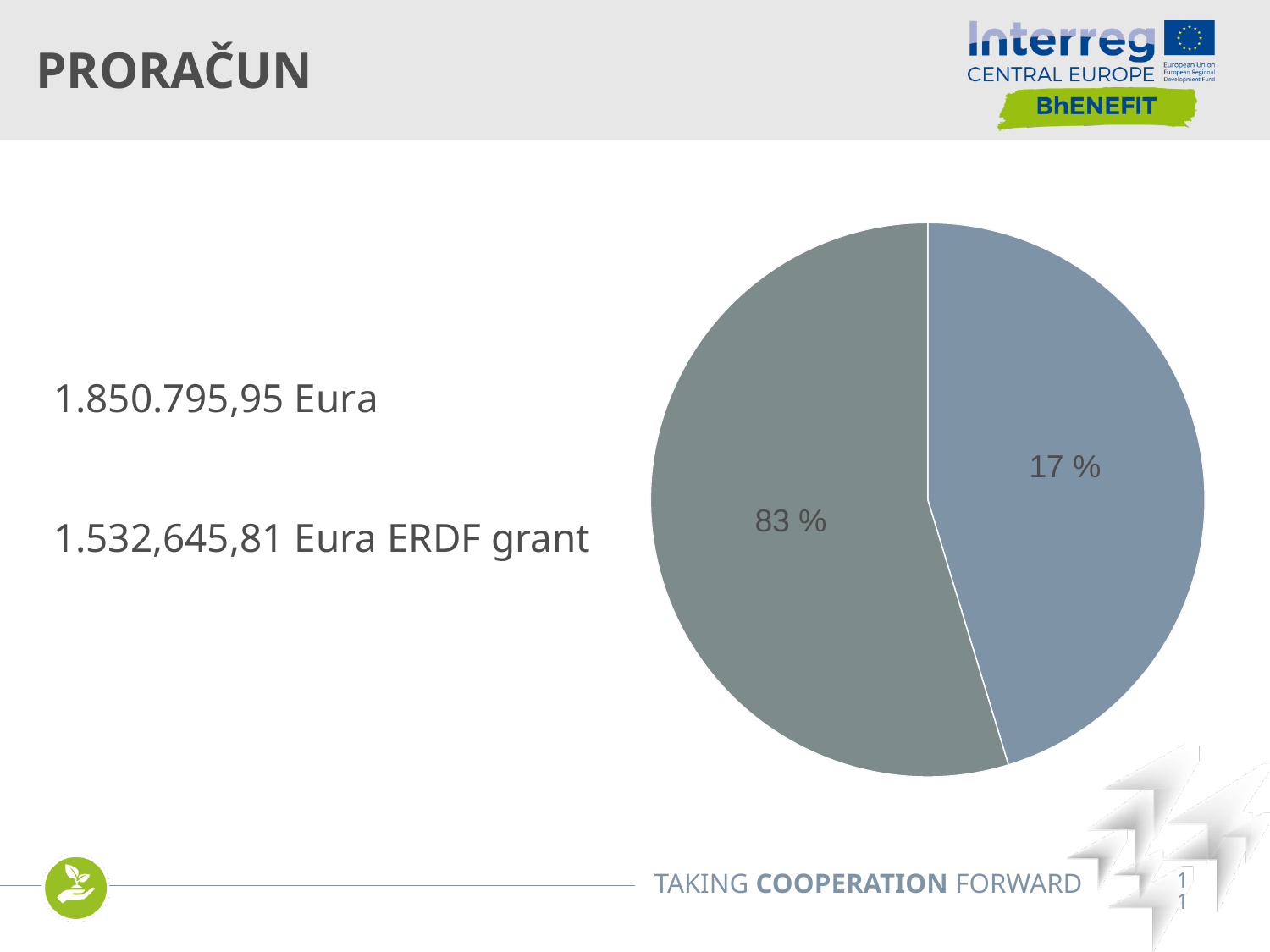
How many slices does the pie chart have? 2 What percentage is shown on the smallest slice of the pie chart? 17 % What is the difference in percentage points between the two slices of the pie chart? 66 Is the share of the grey slice in the pie chart greater or less than 50%? greater Does the pie chart on the slide have a legend? No What share of the pie does the grey slice represent? 83 % What colour is the slice labelled 17 % in the pie chart? blue What percentage is shown on the largest slice of the pie chart? 83 % Which slice is larger in the pie chart, the grey slice or the blue slice? the grey slice What share of the pie does the blue slice represent? 17 % What kind of chart is shown on the slide? pie chart